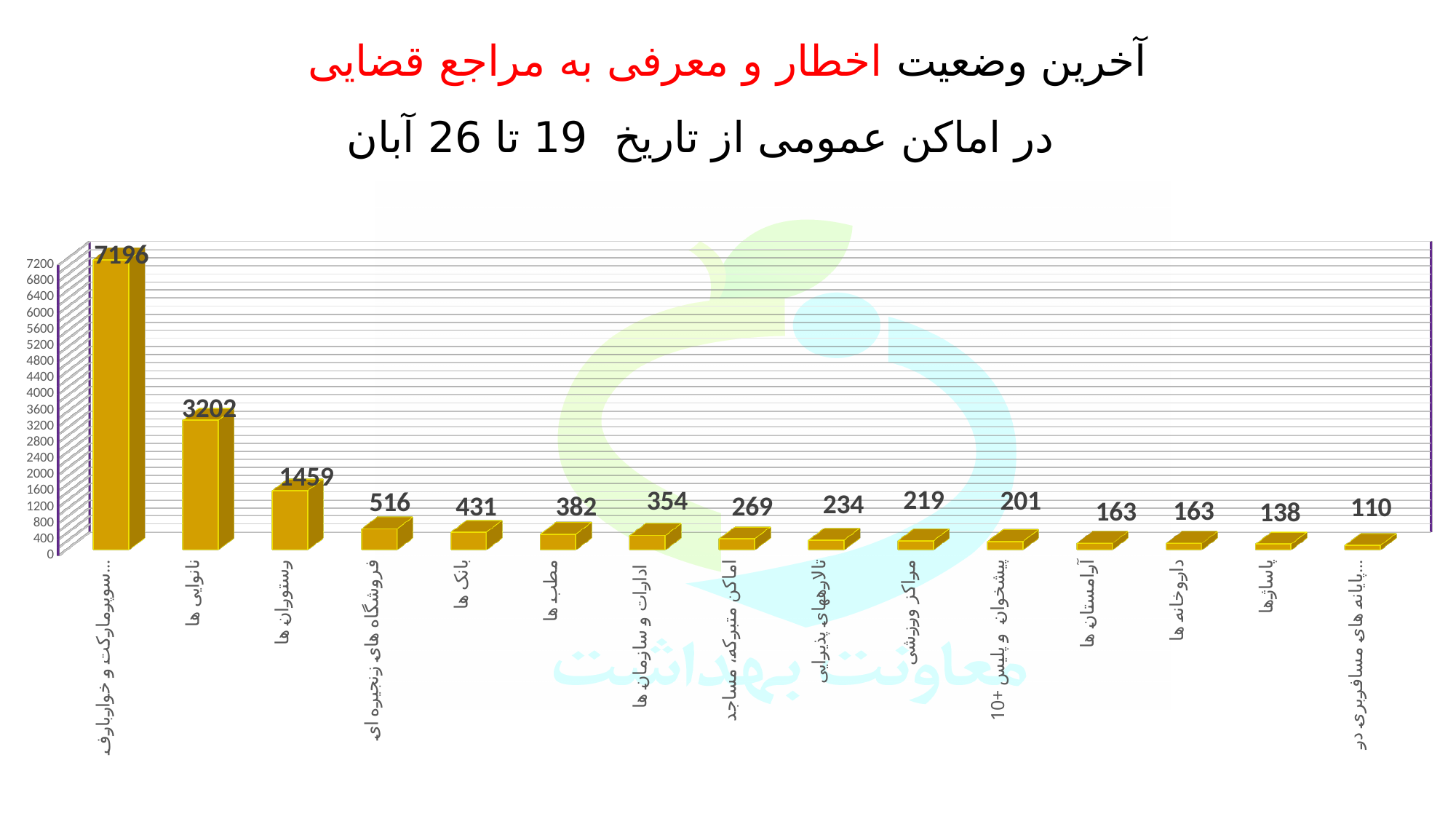
What type of chart is shown on the slide? bar chart What is the difference between the values for نانوایی ها and رستوران ها? 1743 Which has a larger value, مطب ها or ادارات و سازمان ها? مطب ها Do the values rise or fall from left to right along the x axis? fall How many categories are plotted in the chart? 15 What is the value for نانوایی ها? 3202 What is the value for پاساژها? 138 What is the lowest value shown in the chart? 110 What is the value for رستوران ها? 1459 What is the value for فروشگاه های زنجیره ای? 516 What is the value for بانک ها? 431 What is the highest value shown in the chart? 7196